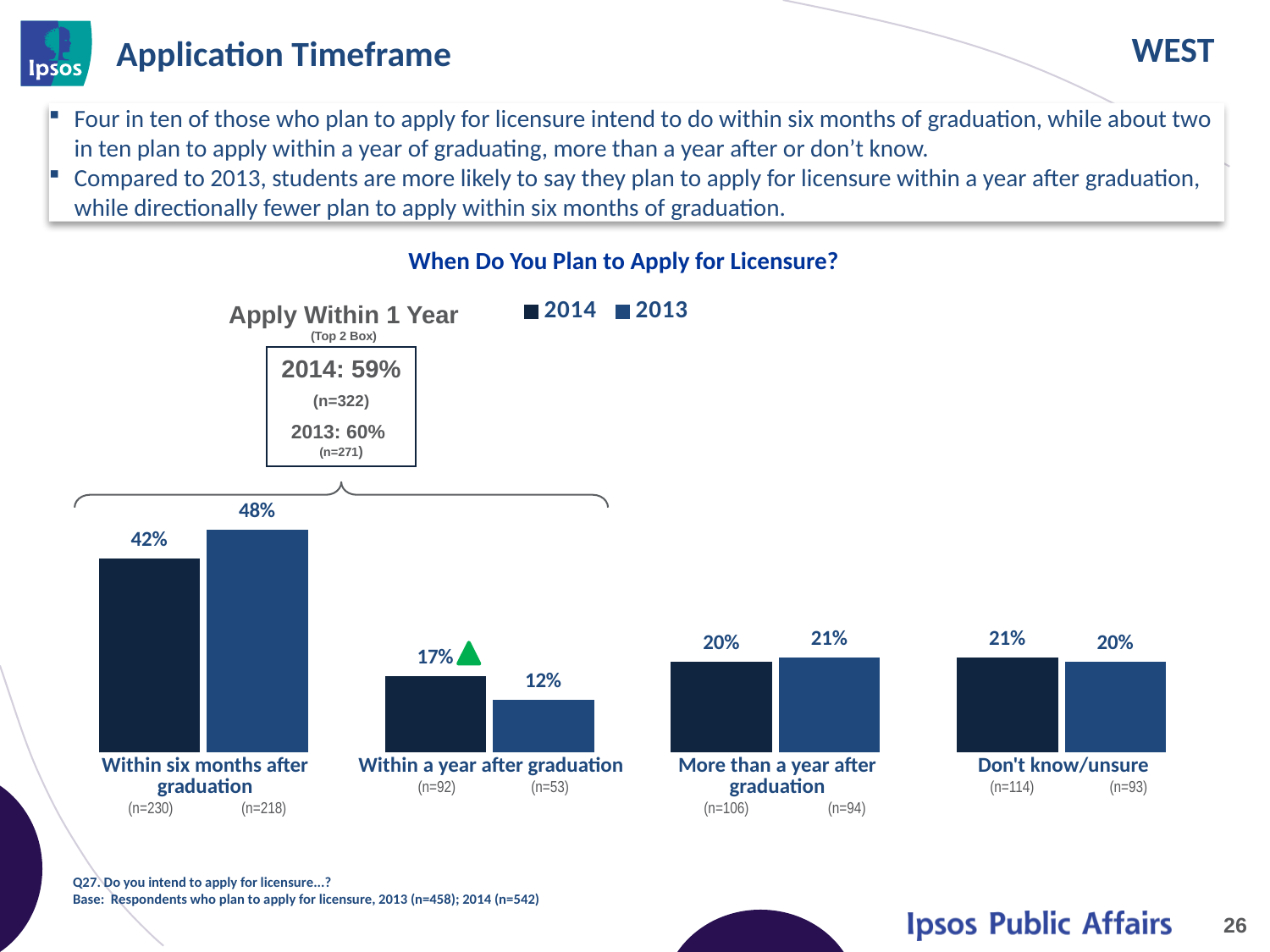
Which category has the lowest 2014 value? Within a year after graduation How many series does the legend list? 2 What kind of chart is shown? Bar chart Which is larger for "Within a year after graduation": the 2014 value or the 2013 value? 2014 What is the 2013 value for "Within a year after graduation"? 12% Which category has the highest 2013 value? Within six months after graduation What is the difference between the 2013 and 2014 values for "Within six months after graduation"? 6% What is the 2014 value for "Within six months after graduation"? 42% What is the title of the chart? When Do You Plan to Apply for Licensure? How many categories are shown on the x axis? 4 What is the 2014 value for "Don't know/unsure"? 21% What is the 2013 value for "More than a year after graduation"? 21%